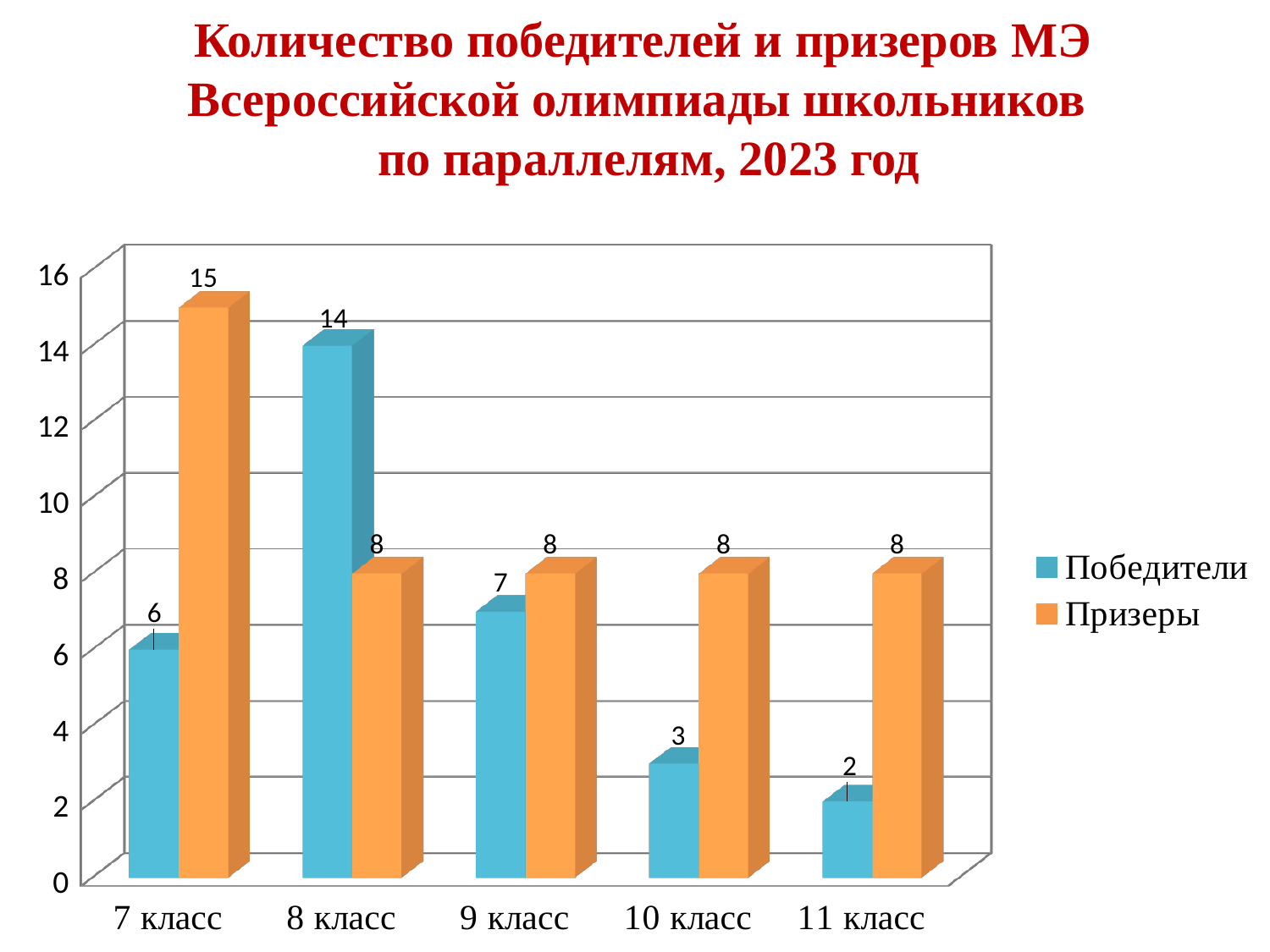
Which class has the highest value for Победители? 8 класс How many classes (categories) are shown on the x axis? 5 What is the value for Победители in 11 класс? 2 What is the difference between Призеры and Победители in 7 класс? 9 Which class has the lowest value for Победители? 11 класс What is the total of Победители and Призеры in 9 класс? 15 What is the value for Призеры in 7 класс? 15 What kind of chart is shown on the slide? bar chart Which is larger in 8 класс: Победители or Призеры? Победители What is the value for Победители in 8 класс? 14 How many series does the legend list? 2 Which class has the highest value for Призеры? 7 класс